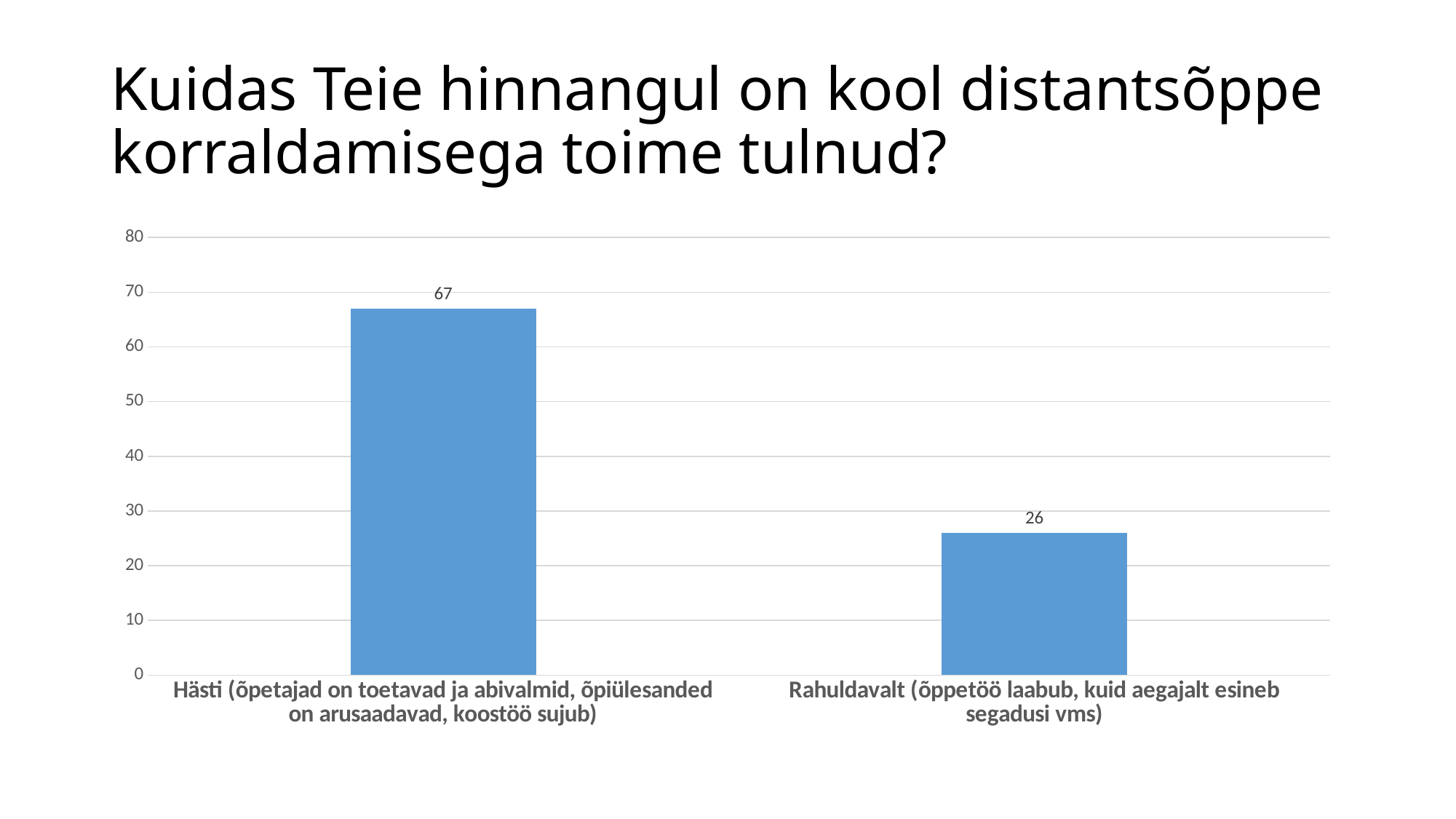
How many categories are shown in the chart? 2 Which category has the lowest value? Rahuldavalt (õppetöö laabub, kuid aegajalt esineb segadusi vms) Is the value for "Rahuldavalt" greater or less than 30? less Which is larger, the value for "Hästi" or the value for "Rahuldavalt"? Hästi What is the value for the "Hästi" category? 67 What kind of chart is shown on the slide? bar chart What is the maximum value shown on the vertical axis? 80 Is the value for "Hästi" greater or less than 60? greater What is the difference between the values for "Hästi" and "Rahuldavalt"? 41 What is the title of the slide? Kuidas Teie hinnangul on kool distantsõppe korraldamisega toime tulnud? Which category has the highest value? Hästi (õpetajad on toetavad ja abivalmid, õpiülesanded on arusaadavad, koostöö sujub) What is the value for the "Rahuldavalt" category? 26